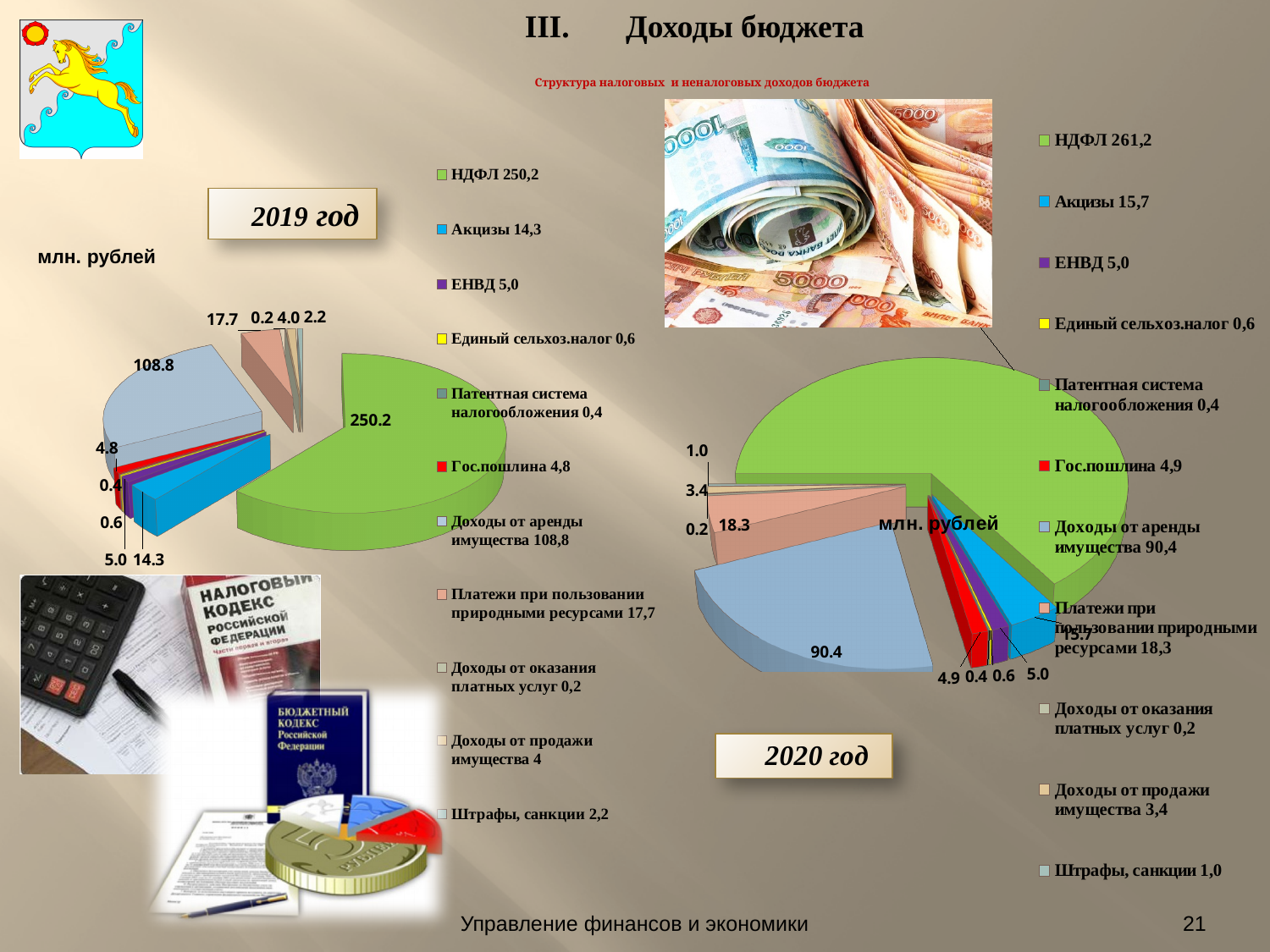
What unit is stated for the values on both charts? млн. рублей What type of chart is used for the 2019 data? Pie chart On the 2019 pie chart, what is the difference between НДФЛ and Доходы от аренды имущества? 141,4 Which is larger: Акцизы in the 2019 chart or Акцизы in the 2020 chart? 2020 (15,7) On the 2020 pie chart, what is the value for Штрафы, санкции? 1,0 On the 2019 pie chart, which category has the smallest value? Доходы от оказания платных услуг On the 2019 pie chart, what is the value for Платежи при пользовании природными ресурсами? 17,7 On the 2019 pie chart, what is the value for НДФЛ? 250,2 On the 2020 pie chart, what is the value for Доходы от аренды имущества? 90,4 On the 2020 pie chart, which category has the largest value? НДФЛ What is the difference between НДФЛ in the 2020 chart and НДФЛ in the 2019 chart? 11,0 How many categories does the 2020 pie chart's legend list? 11